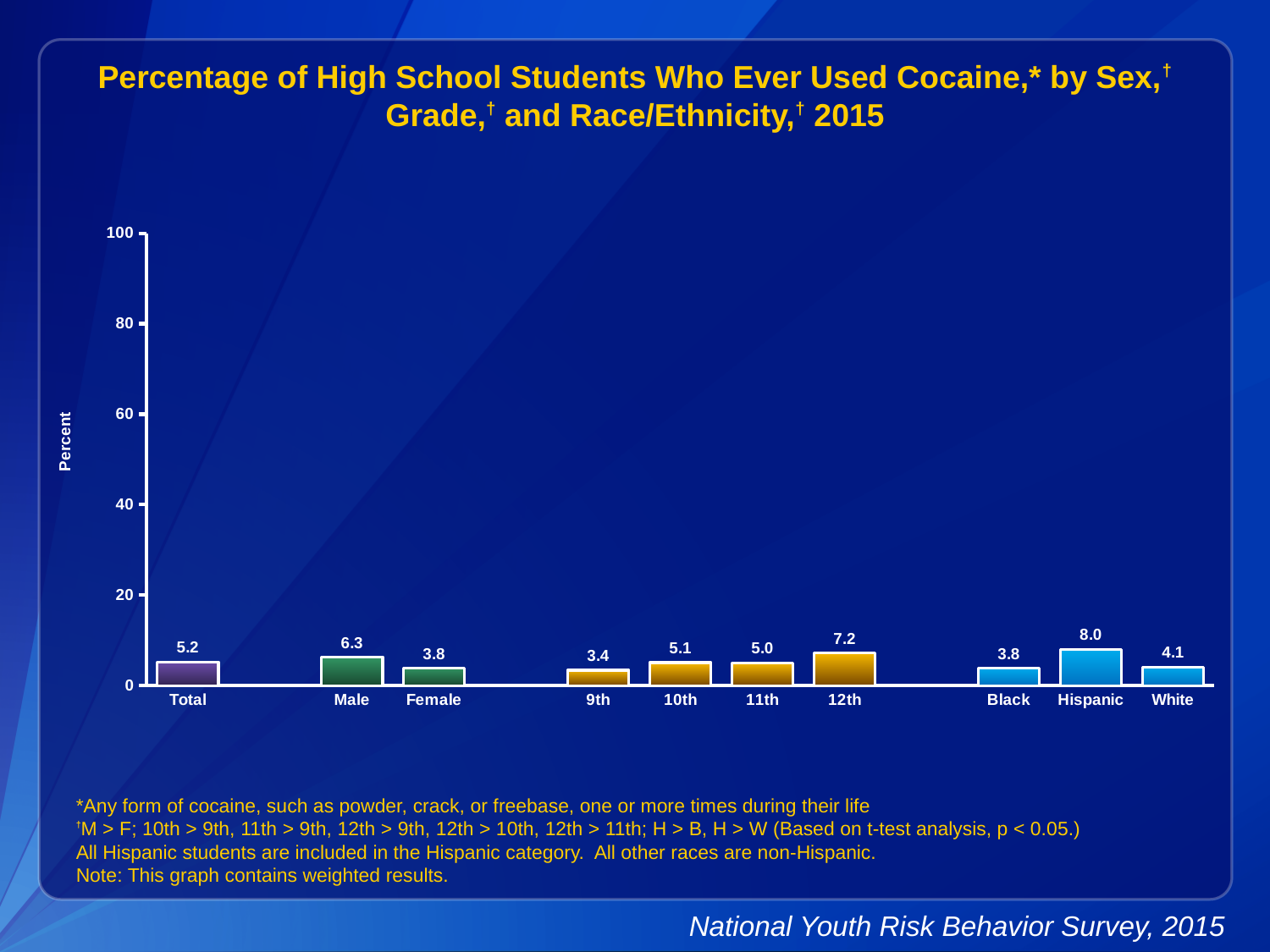
Is the value for Hispanic greater or less than 20? less What kind of chart is this? bar chart Which category has the lowest value? 9th What is the value for Hispanic? 8.0 How many categories are shown on the x axis? 10 Which category has the highest value? Hispanic What is the value for Male? 6.3 What is the value for 12th grade? 7.2 What is the value for Total? 5.2 Which is larger, the value for 12th grade or the value for 9th grade? 12th What is the label of the y axis? Percent What is the difference between the Male and Female values? 2.5